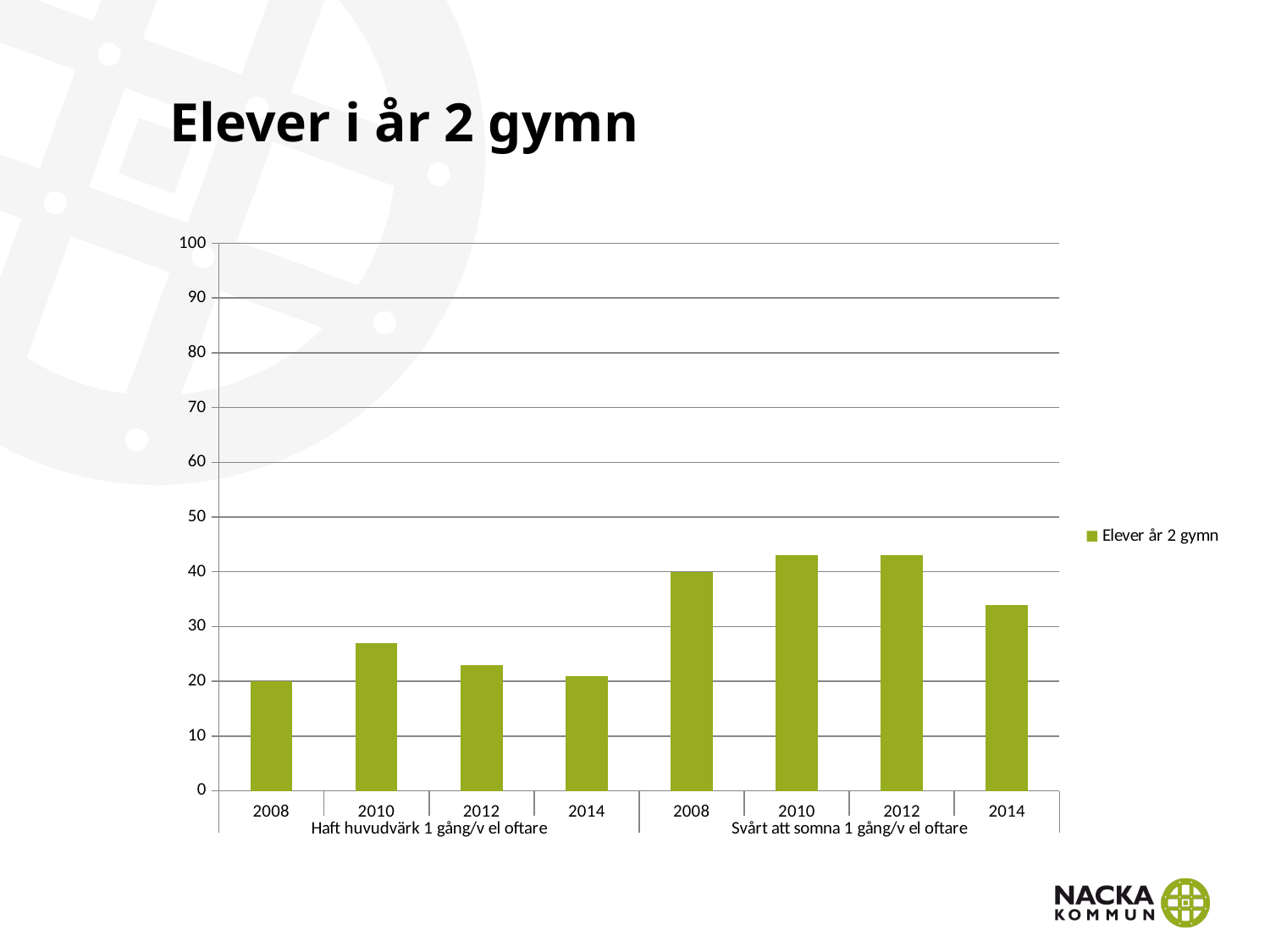
What is the value for 2008 in the 'Svårt att somna 1 gång/v el oftare' group? 40 How many series does the legend list? 1 Is the value for 2010 in the 'Svårt att somna 1 gång/v el oftare' group greater or less than 40? greater Which year has the lowest value in the 'Svårt att somna 1 gång/v el oftare' group? 2014 Is the value for 2014 in the 'Svårt att somna 1 gång/v el oftare' group greater or less than 40? less How many bars are plotted in the chart? 8 What is the legend entry for the series? Elever år 2 gymn What is the value for 2008 in the 'Haft huvudvärk 1 gång/v el oftare' group? 20 What type of chart is shown on the slide? bar chart In the 'Haft huvudvärk 1 gång/v el oftare' group, which is larger, the value for 2010 or the value for 2012? 2010 Which year has the highest value in the 'Haft huvudvärk 1 gång/v el oftare' group? 2010 Is the value for 2010 in the 'Haft huvudvärk 1 gång/v el oftare' group greater or less than 30? less